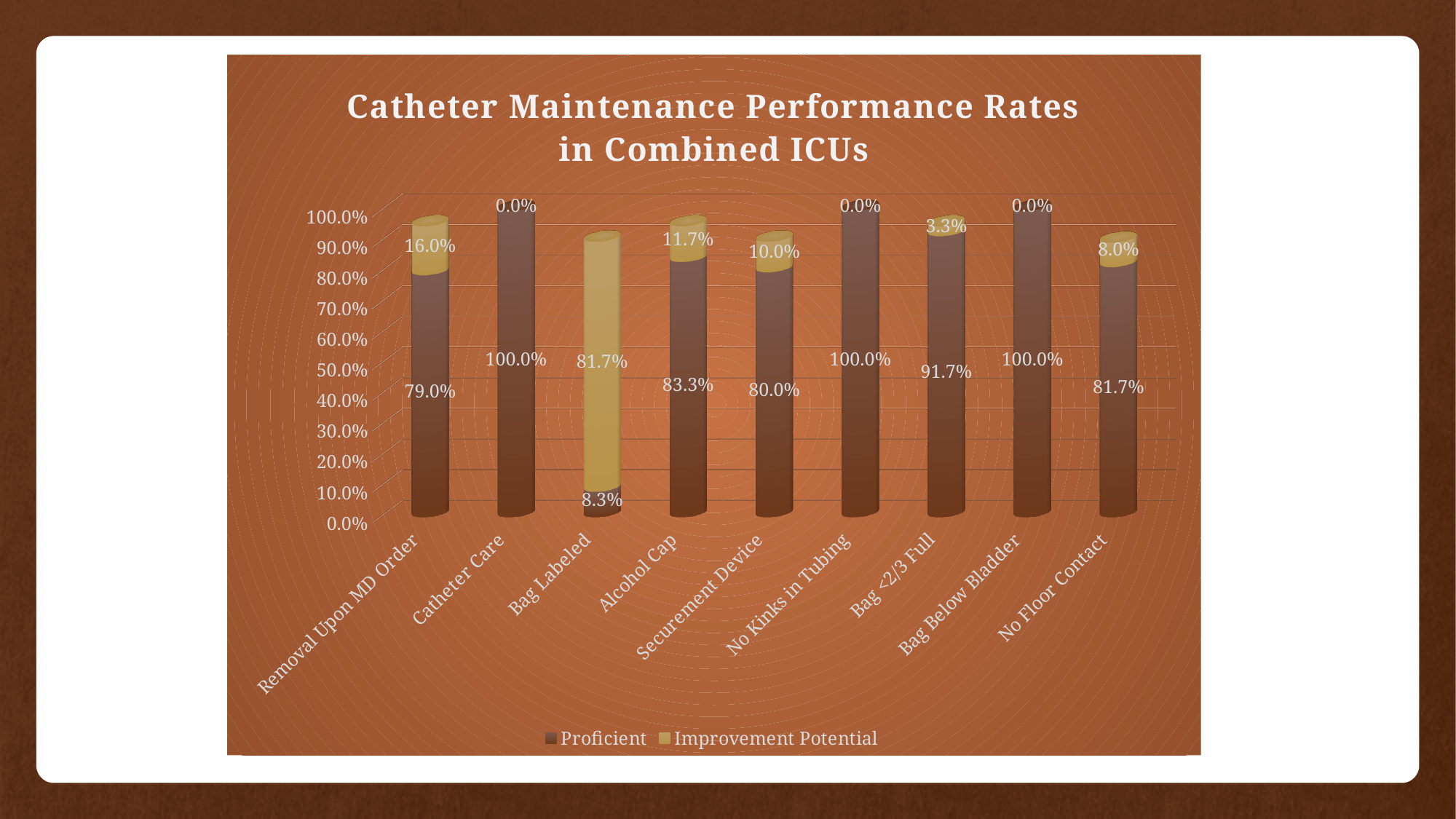
What is the difference between the Proficient values for Alcohol Cap and Securement Device? 3.3% What is the Proficient value for Removal Upon MD Order? 79.0% What is the Proficient value for Bag <2/3 Full? 91.7% Which category has the highest Improvement Potential value? Bag Labeled What is the total of the stacked bar for Removal Upon MD Order? 95.0% Which has a larger Proficient value, Bag <2/3 Full or No Floor Contact? Bag <2/3 Full What is the Improvement Potential value for Alcohol Cap? 11.7% What is the title of the chart? Catheter Maintenance Performance Rates in Combined ICUs Which category has the lowest Proficient value? Bag Labeled What kind of chart is shown on the slide? Stacked bar chart How many categories are shown on the x axis? 9 How many series does the legend list? 2